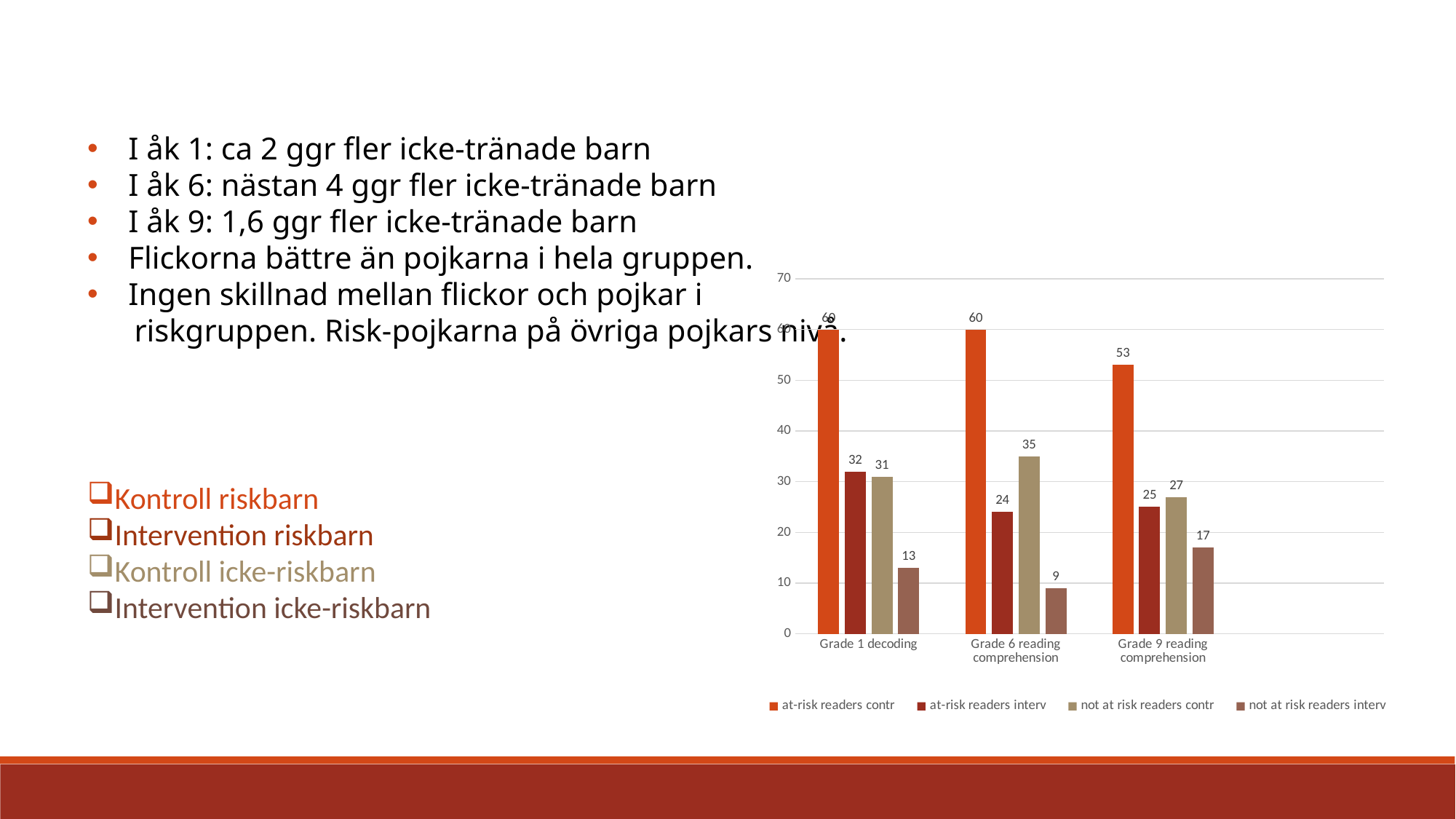
What is the value for at-risk readers contr in Grade 9 reading comprehension? 53 What is the difference between at-risk readers contr and at-risk readers interv in Grade 6 reading comprehension? 36 What is the value for not at risk readers interv in Grade 9 reading comprehension? 17 How many categories are shown on the x axis? 3 Which series has the highest value in Grade 6 reading comprehension? at-risk readers contr Is the value for at-risk readers contr in Grade 1 decoding greater or less than 50? greater Which category has the lowest value for not at risk readers interv? Grade 6 reading comprehension What is the value for at-risk readers interv in Grade 1 decoding? 32 What kind of chart is shown on the slide? bar chart What is the value for not at risk readers contr in Grade 6 reading comprehension? 35 How many series does the legend list? 4 Which is larger in Grade 9 reading comprehension: not at risk readers contr or not at risk readers interv? not at risk readers contr